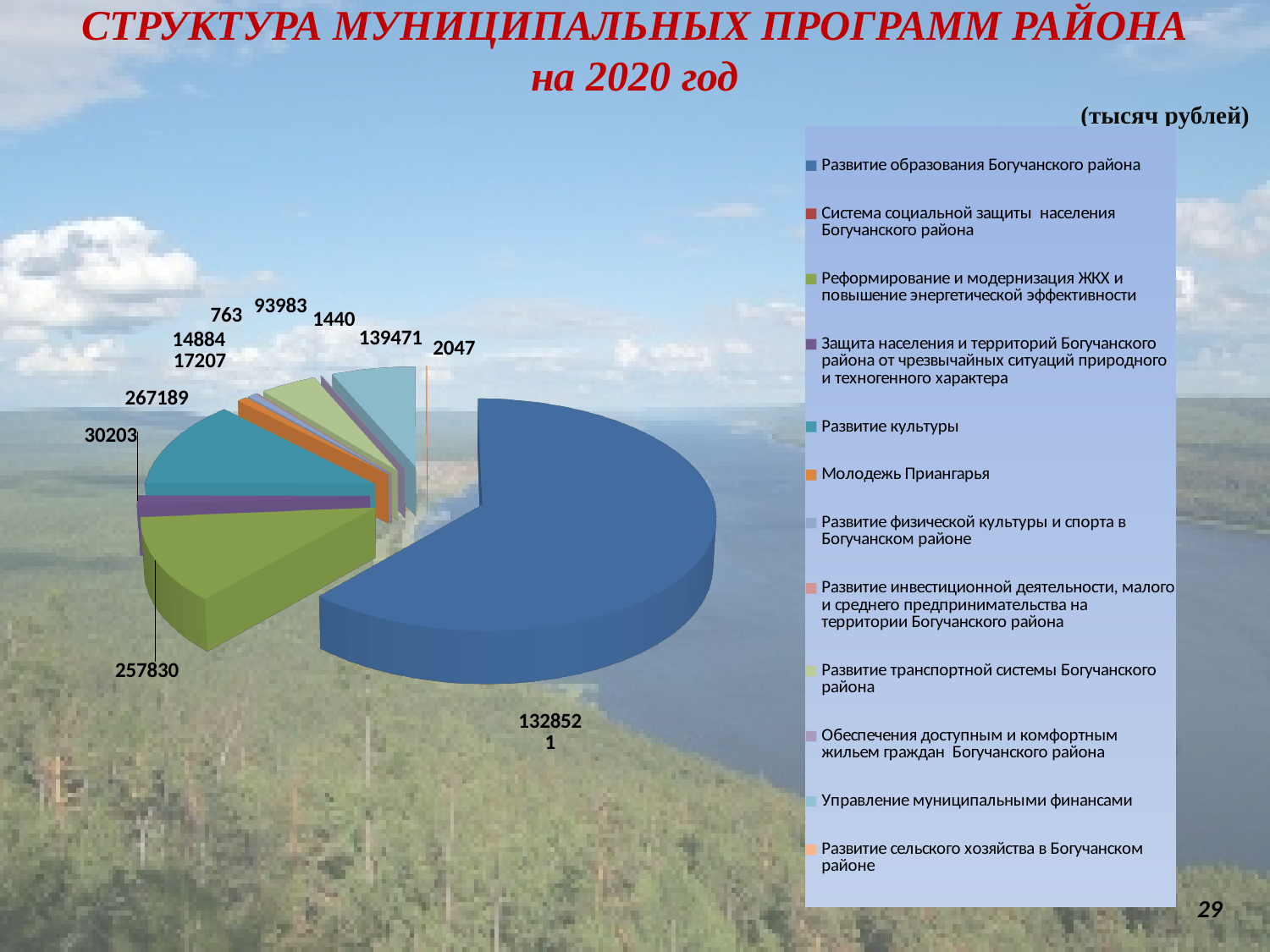
In what units are the values on the chart given, according to the slide? тысяч рублей What kind of chart is shown on the slide? pie chart What is the value shown for the teal slice, Развитие культуры? 267189 How many entries does the chart legend list? 12 What is the smallest value printed as a data label on the pie chart? 763 What is the value shown for the green slice, Реформирование и модернизация ЖКХ и повышение энергетической эффективности? 257830 What is the value shown for the largest slice (Развитие образования Богучанского района)? 1328521 What year does the chart title refer to? 2020 How many data labels are printed on the pie chart? 11 Which programme has the largest slice of the pie? Развитие образования Богучанского района What is the difference between the values 267189 and 257830 shown on the pie chart? 9359 Which is larger: the value for Развитие культуры (267189) or for Реформирование и модернизация ЖКХ (257830)? Развитие культуры